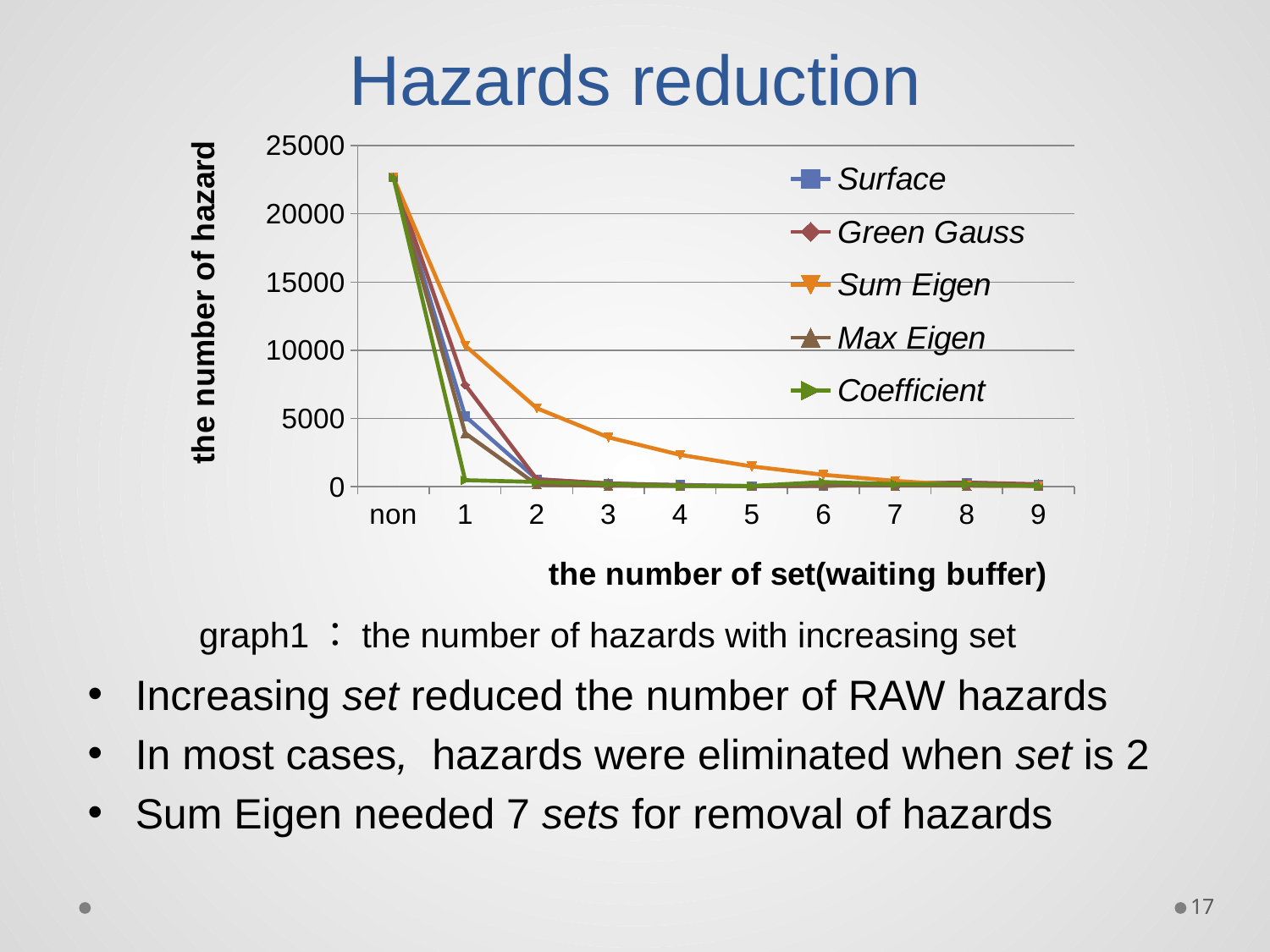
What kind of chart is shown on the slide? line chart Which series has the highest number of hazards at set 1? Sum Eigen Is the value for Sum Eigen at 'non' greater or less than 20000? greater How many series does the legend list? 5 Is the value for Green Gauss at set 1 greater or less than 5000? greater Is the value for Sum Eigen at set 2 greater or less than 5000? greater Do the values for Sum Eigen rise or fall as the number of sets increases along the x axis? fall At set 3, which is larger: the value for Sum Eigen or the value for Coefficient? Sum Eigen Which series has the lowest number of hazards at set 1? Coefficient How many categories are shown along the x axis? 10 What is the title of the x axis? the number of set(waiting buffer)